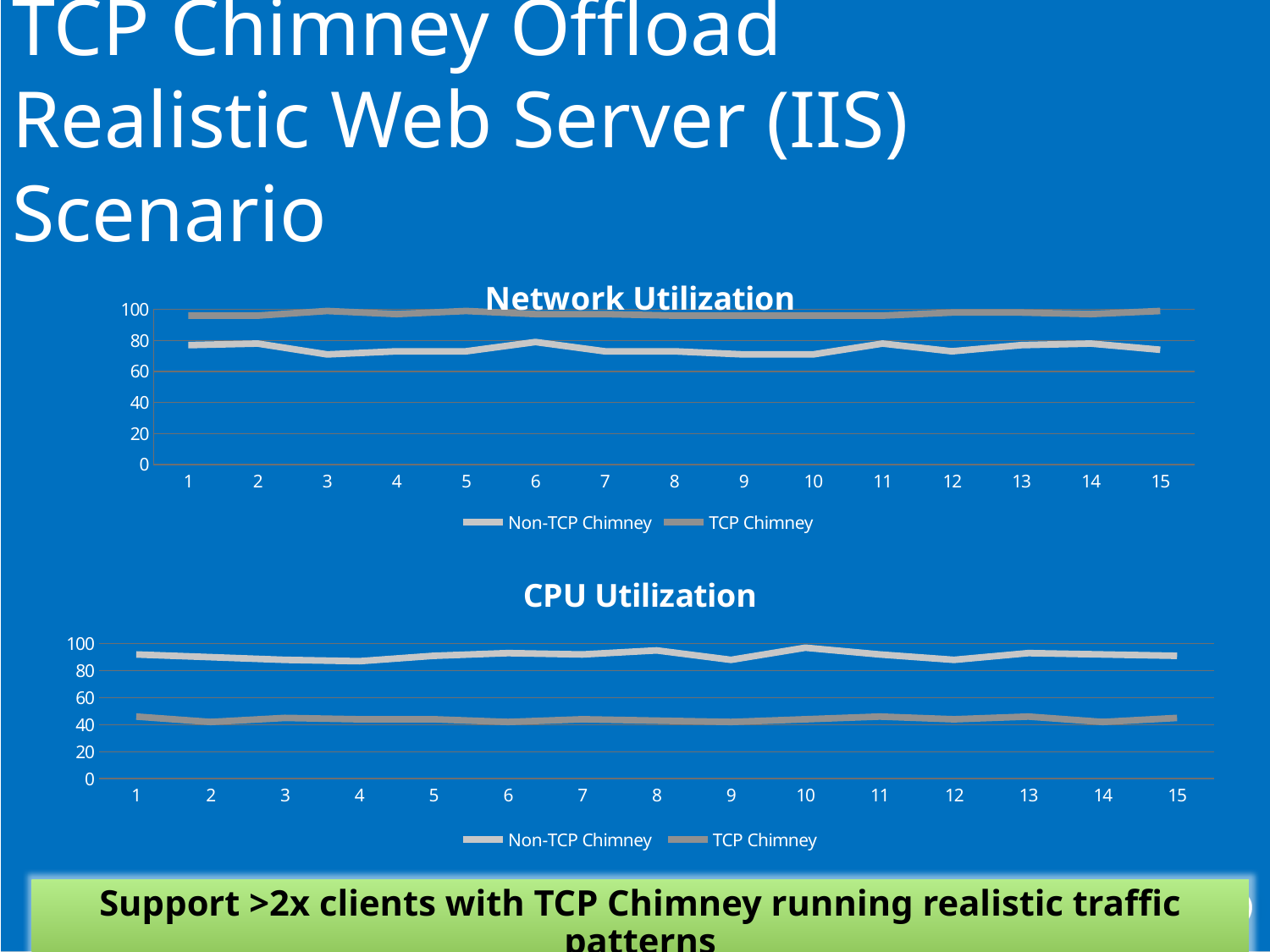
How many series does the legend of the Network Utilization chart list? 2 In the CPU Utilization chart, is the value for Non-TCP Chimney at point 10 greater or less than 80? greater How many points are plotted along the x axis of the CPU Utilization chart? 15 In the Network Utilization chart, which series is higher at point 5, Non-TCP Chimney or TCP Chimney? TCP Chimney In the Network Utilization chart, is the value for TCP Chimney at point 1 greater or less than 80? greater What type of chart is the Network Utilization chart? line chart What are the two series named in the legend of the CPU Utilization chart? Non-TCP Chimney and TCP Chimney What is the title of the upper chart on the slide? Network Utilization In the CPU Utilization chart, which series is higher at point 10, Non-TCP Chimney or TCP Chimney? Non-TCP Chimney What type of chart is the CPU Utilization chart? line chart In the CPU Utilization chart, is the value for TCP Chimney at point 1 greater or less than 60? less